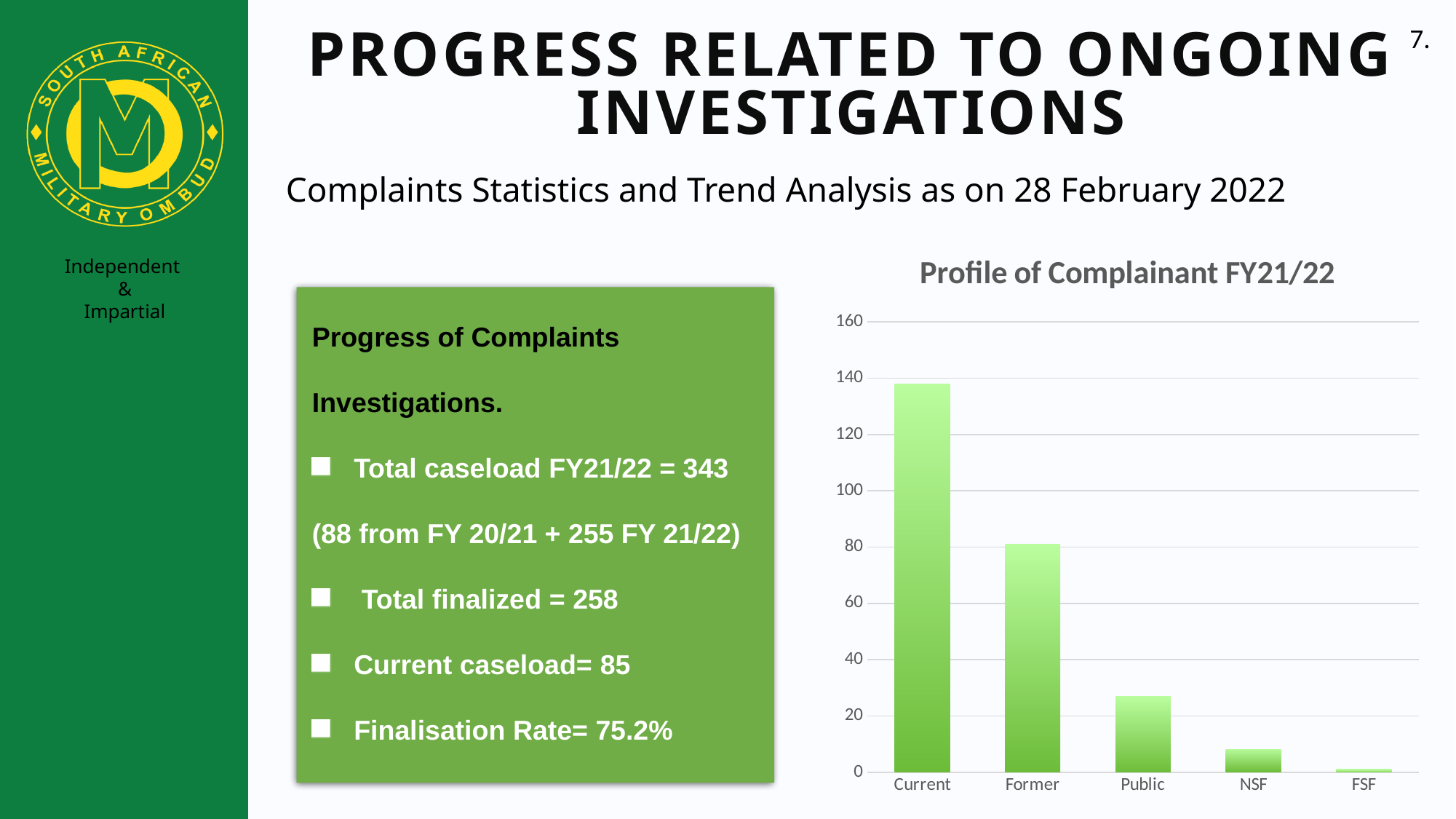
What is the highest value shown on the vertical axis of the chart? 160 Is the value for Public greater or less than 20? greater Which has a larger value, Former or Public? Former Is the value for Current greater or less than 120? greater How many categories are shown on the x axis of the chart? 5 What is the title of the chart on the slide? Profile of Complainant FY21/22 Do the values rise or fall moving from Current to FSF along the x axis? fall Which category has the lowest value in the chart? FSF What kind of chart is shown on the slide? bar chart Is the value for NSF greater or less than 20? less Which category has the highest value in the chart? Current